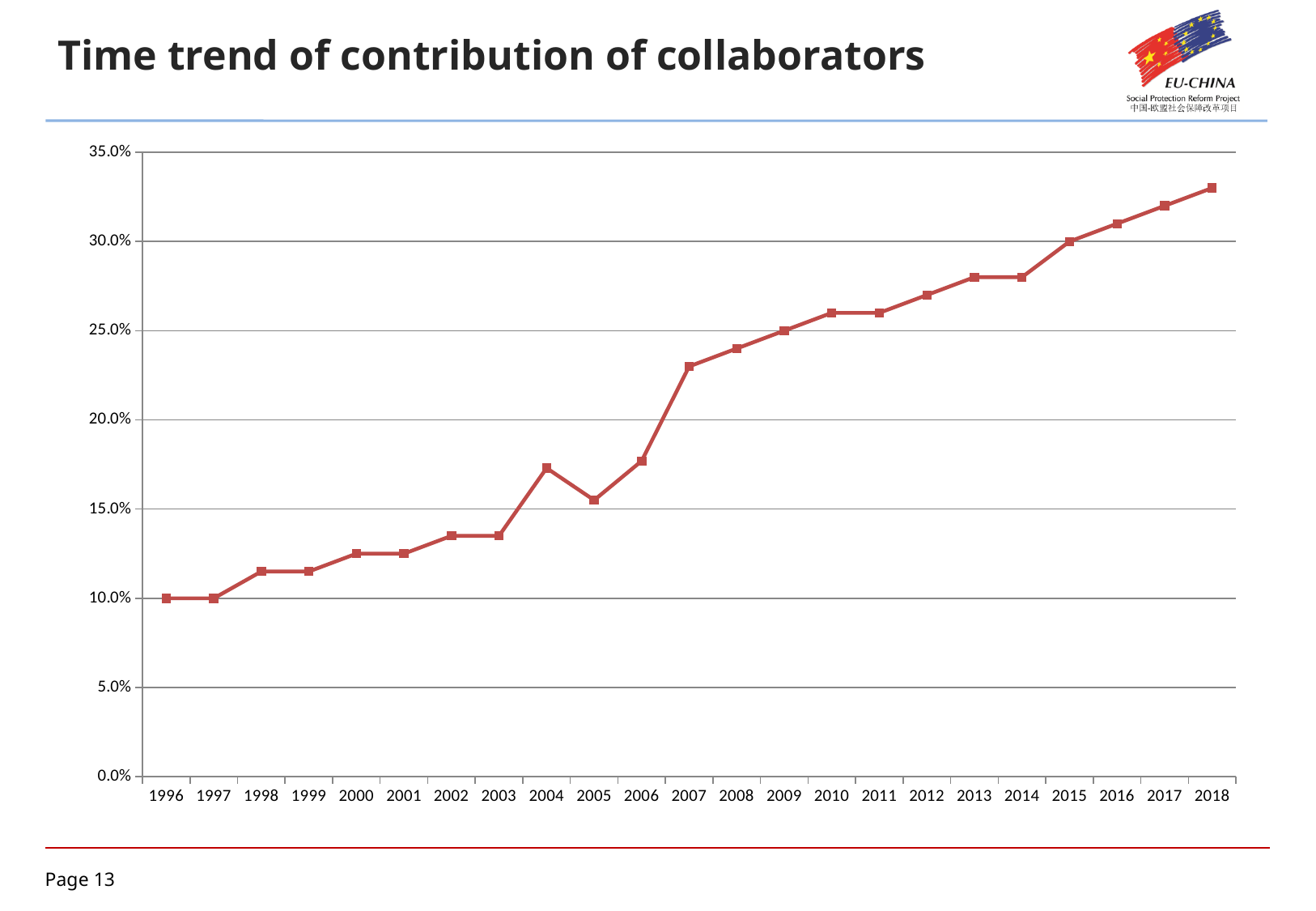
Is the value for 2003 greater or less than 15.0%? less What kind of chart is shown on the slide? line chart What is the title of the chart? Time trend of contribution of collaborators What is the value for 2009? 25.0% Do the values generally rise or fall from 1996 to 2018? rise What is the difference between the value for 2015 and the value for 1996? 20.0% What is the value for 1996? 10.0% Which year has the highest value? 2018 What is the value for 2015? 30.0% How many years are plotted on the x axis? 23 Is the value for 2004 greater or less than 15.0%? greater Which is larger, the value for 2004 or the value for 2005? 2004